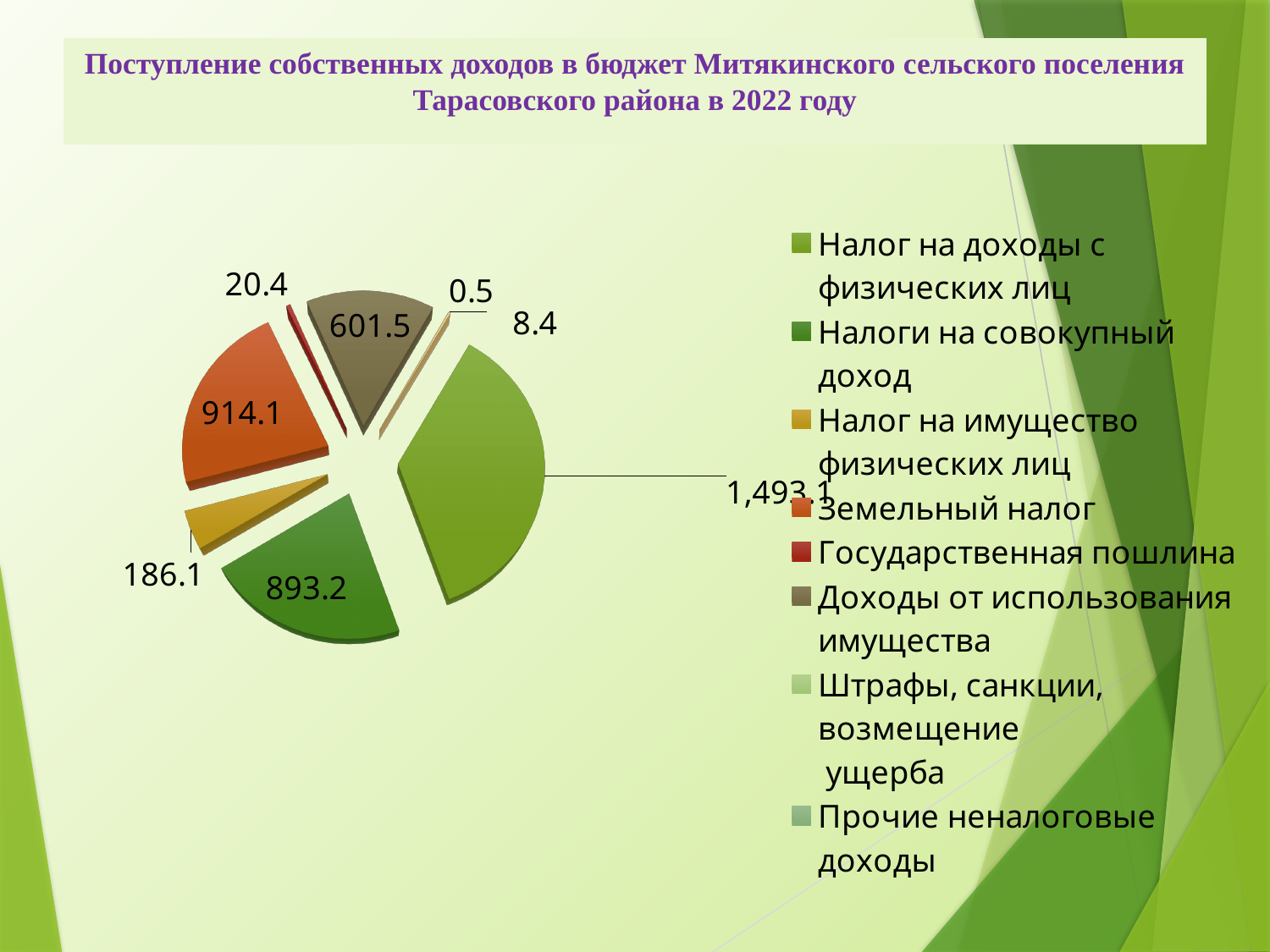
Which is larger: Земельный налог or Налоги на совокупный доход? Земельный налог What is the title of the slide containing the chart? Поступление собственных доходов в бюджет Митякинского сельского поселения Тарасовского района в 2022 году What is the value for Доходы от использования имущества? 601.5 What is the value for Налог на доходы с физических лиц? 1,493.1 What is the value for Налог на имущество физических лиц? 186.1 Which category has the largest slice of the pie? Налог на доходы с физических лиц What is the difference between Земельный налог and Налоги на совокупный доход? 20.9 What is the value for Государственная пошлина? 20.4 How many categories does the legend list? 8 What is the value for Земельный налог? 914.1 Which category has the smallest value? Штрафы, санкции, возмещение ущерба What type of chart is shown on the slide? pie chart